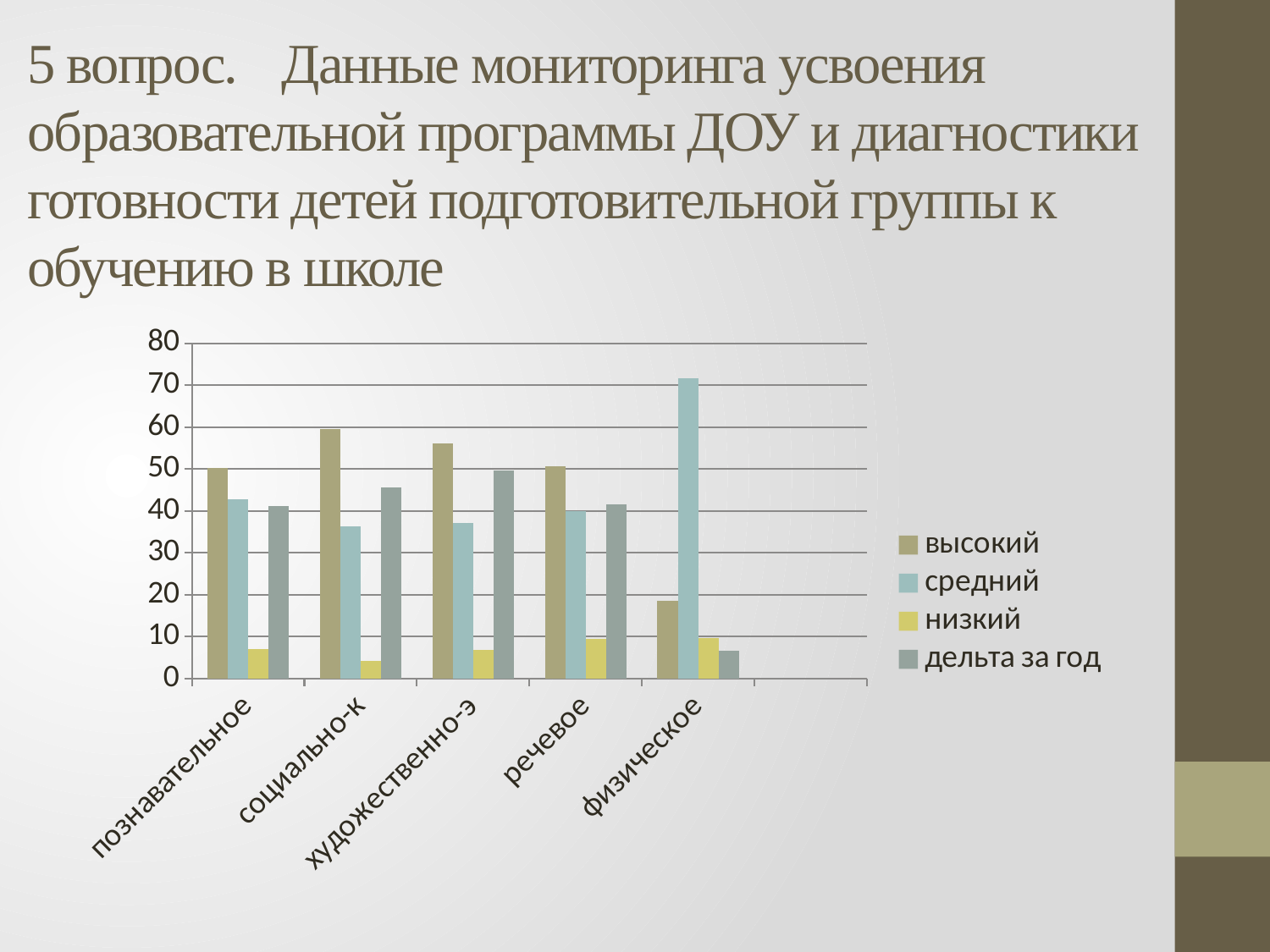
For физическое, which is larger: 'высокий' or 'средний'? средний How many categories are shown on the x axis of the chart? 5 Which category has the lowest value for the series 'низкий'? социально-к What kind of chart is shown on the slide? bar chart Which category has the lowest value for the series 'высокий'? физическое Which category has the highest value for the series 'средний'? физическое Is the value of 'дельта за год' for художественно-э greater or less than 40? greater Which series is listed last in the chart legend? дельта за год Is the value of 'высокий' for физическое greater or less than 20? less Is the value of 'средний' for физическое greater or less than 60? greater How many series does the chart legend list? 4 Which category has the highest value for the series 'высокий'? социально-к